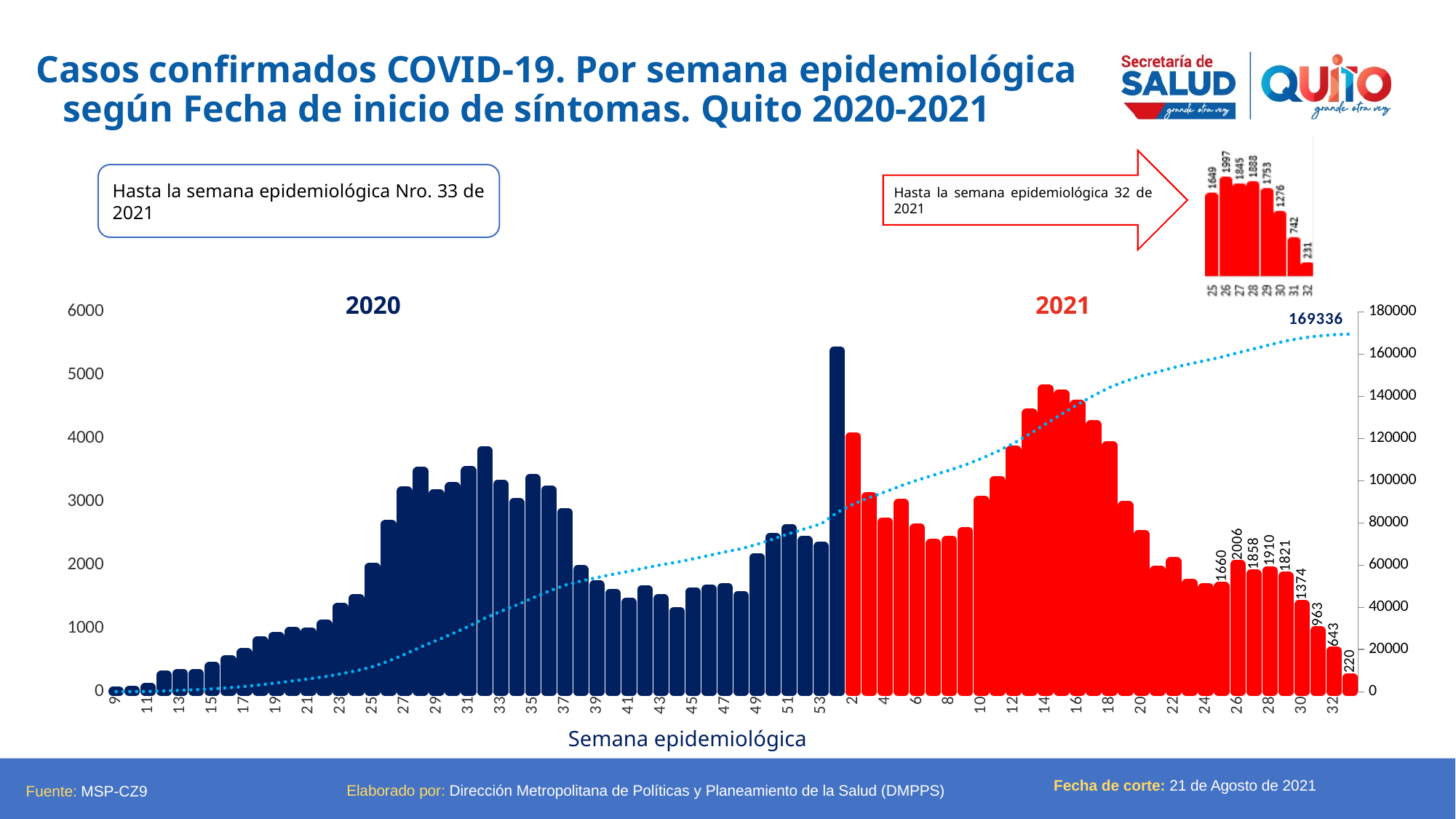
What is the x-axis title of the main chart? Semana epidemiológica On the main chart, what is the difference between the values for week 26 and week 27 of 2021? 148 On the small inset chart at the top right, how many bars are shown? 8 On the main chart, what is the final value shown for the dotted cumulative line? 169336 On the small inset chart at the top right, what is the value for week 25? 1649 On the main chart, what is the value for epidemiological week 33 of 2021? 220 On the small inset chart at the top right, which week has the lowest value? 32 On the main chart, which is larger: the value for week 28 of 2021 or week 27 of 2021? Week 28 of 2021 On the small inset chart at the top right, which week has the highest value? 26 On the main chart, what is the value for epidemiological week 26 of 2021? 2006 On the small inset chart at the top right, what is the difference between the values for week 26 and week 32? 1766 On the main chart, is the value for week 14 of 2021 greater or less than 4000? greater